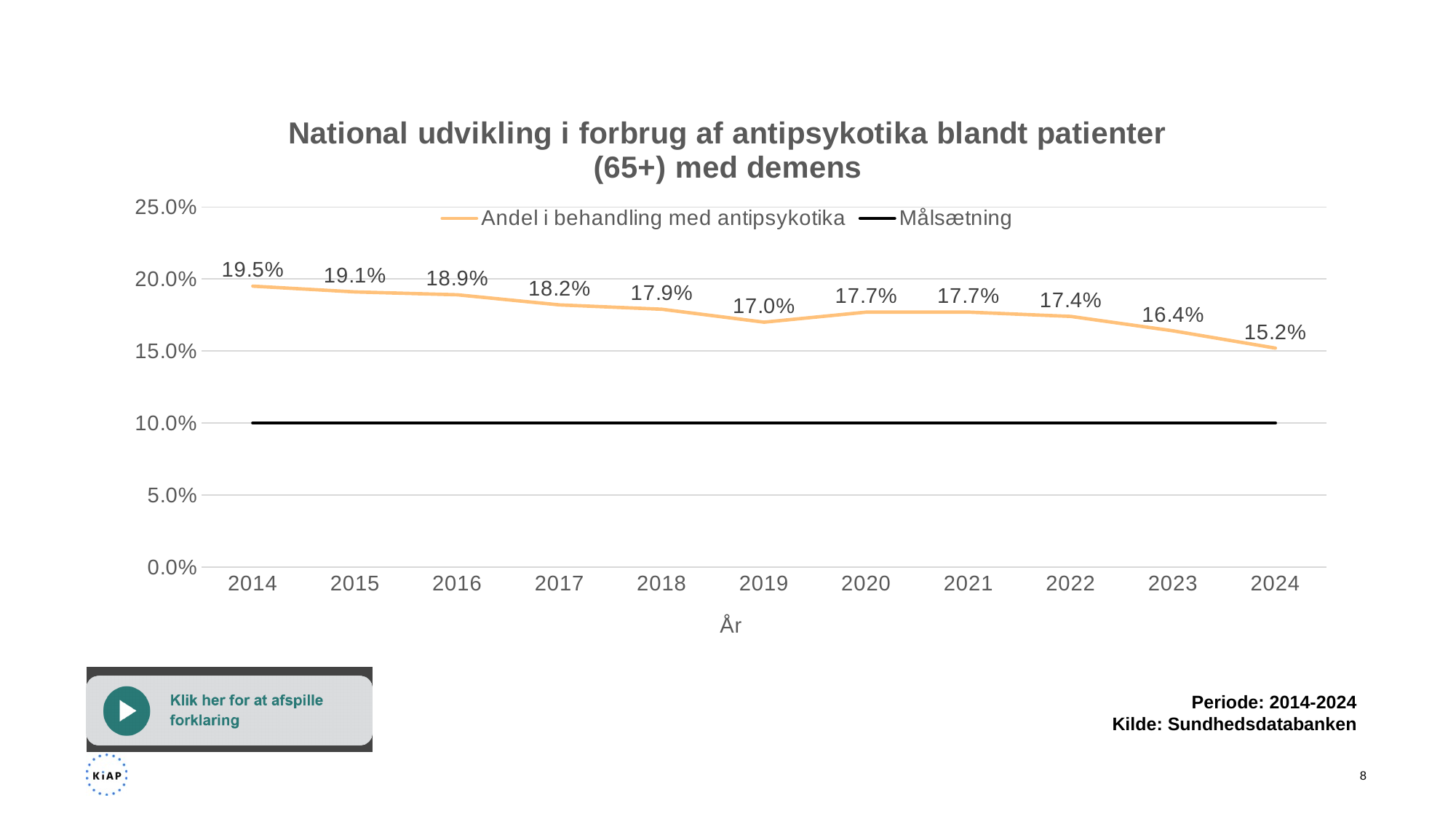
What is the value for 'Andel i behandling med antipsykotika' in 2019? 17.0% What is the value for 'Andel i behandling med antipsykotika' in 2024? 15.2% Is the 'Målsætning' line greater or less than 15.0%? less In which year is 'Andel i behandling med antipsykotika' highest? 2014 How many years are shown on the x axis? 11 Does 'Andel i behandling med antipsykotika' generally rise or fall from 2014 to 2024? fall Which is larger, the value for 2017 or the value for 2022? 2017 How many series does the legend list? 2 What kind of chart is shown? line chart What is the value for 'Andel i behandling med antipsykotika' in 2014? 19.5% In which year is 'Andel i behandling med antipsykotika' lowest? 2024 What is the difference between the 2014 and 2024 values for 'Andel i behandling med antipsykotika'? 4.3%